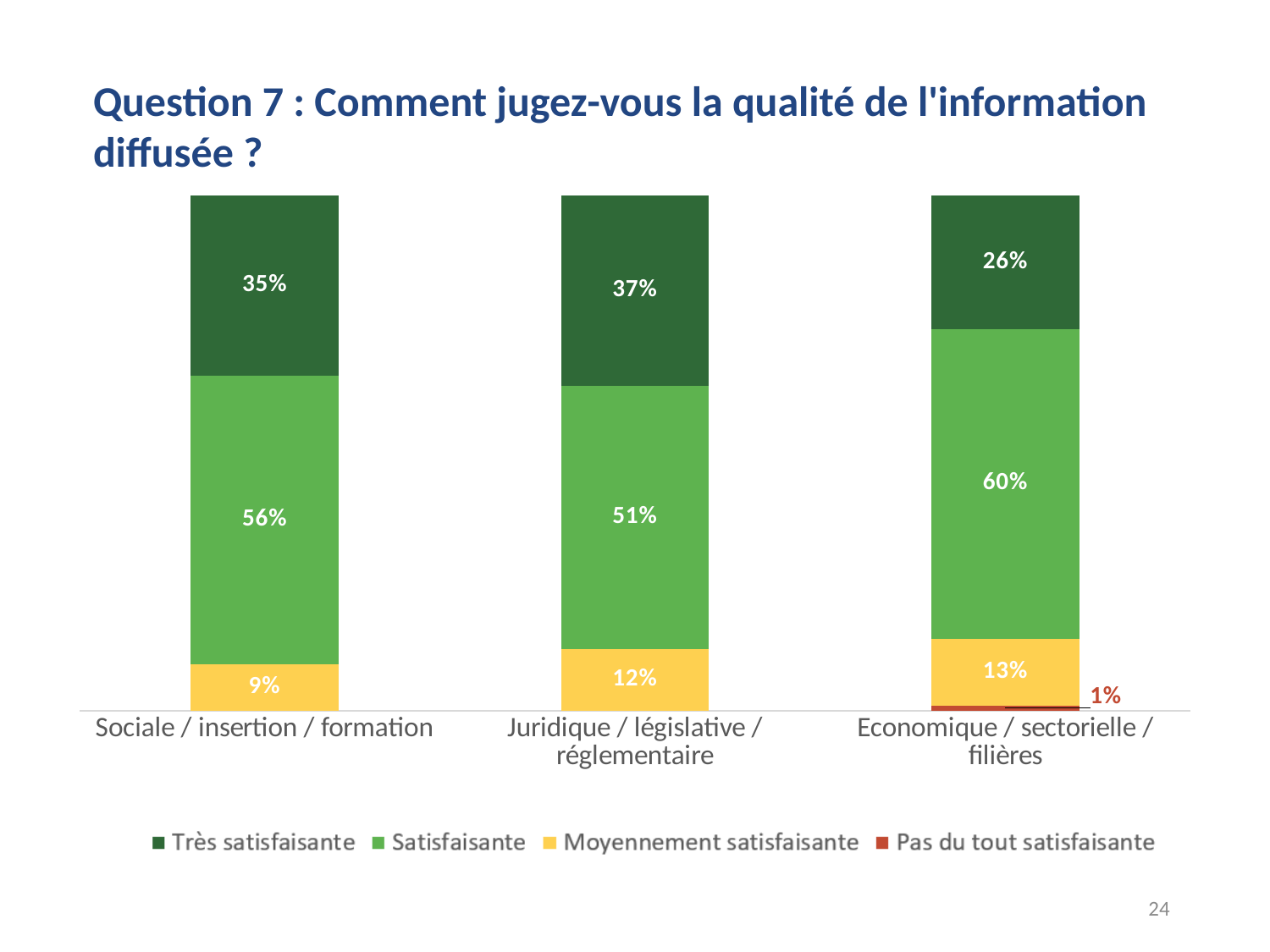
How many categories are shown on the x axis? 3 What kind of chart is shown on the slide? Stacked bar chart Which category has the highest value for "Satisfaisante"? Economique / sectorielle / filières What is the value for "Pas du tout satisfaisante" in the "Economique / sectorielle / filières" category? 1% What is the value for "Très satisfaisante" in the "Juridique / législative / réglementaire" category? 37% How many series does the legend list? 4 What is the value for "Satisfaisante" in the "Sociale / insertion / formation" category? 56% Which category has the lowest value for "Moyennement satisfaisante"? Sociale / insertion / formation Which legend entry is shown in dark green? Très satisfaisante What is the value for "Moyennement satisfaisante" in the "Economique / sectorielle / filières" category? 13% What is the difference between the "Très satisfaisante" values for "Juridique / législative / réglementaire" and "Economique / sectorielle / filières"? 11% Which is larger: the "Satisfaisante" value for "Sociale / insertion / formation" or for "Juridique / législative / réglementaire"? Sociale / insertion / formation